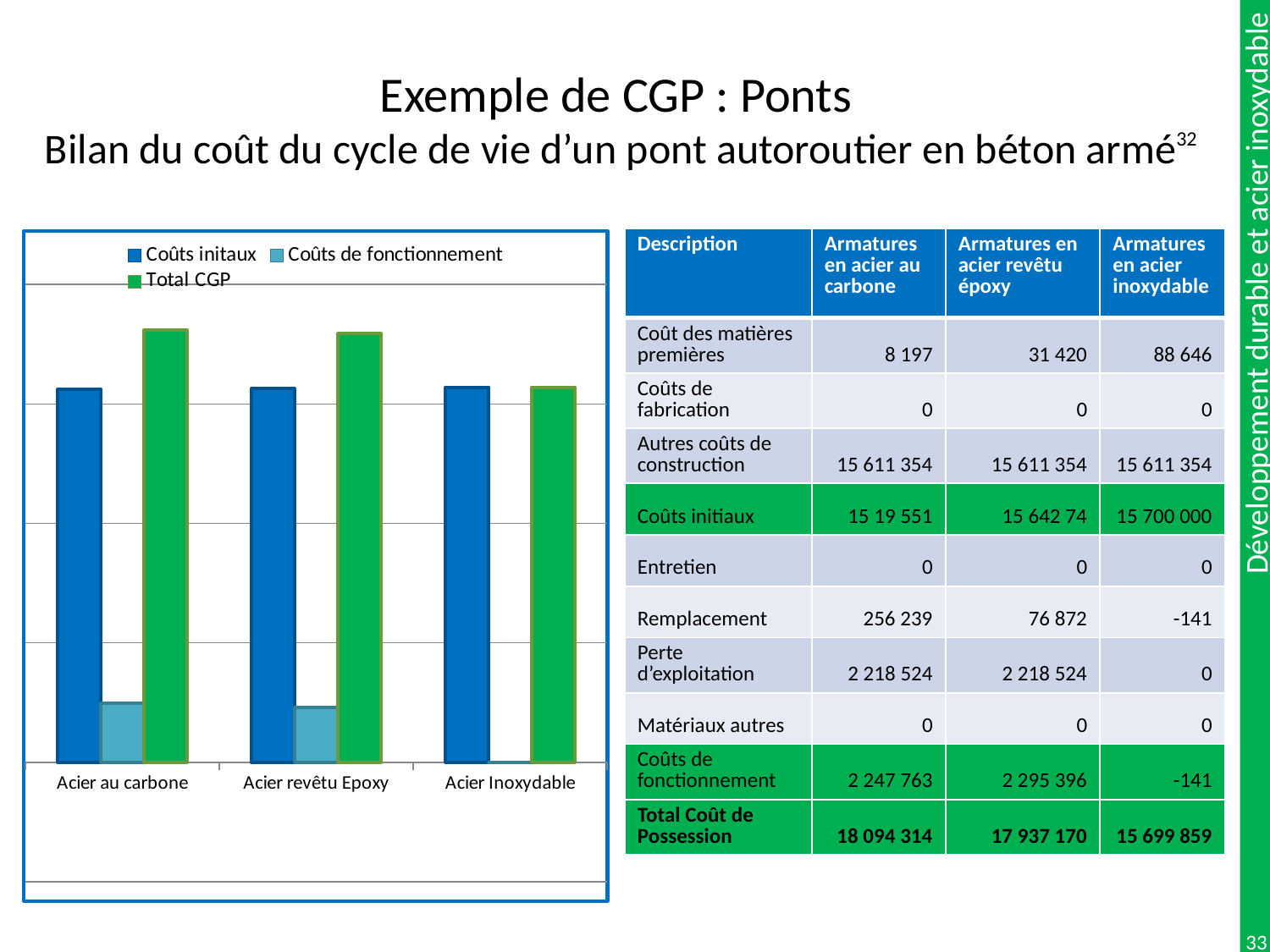
How many series does the chart legend list? 3 How many categories are shown on the x axis of the chart? 3 Which category has the lowest Coûts de fonctionnement bar in the chart? Acier Inoxydable Which category has the lowest Total CGP bar in the chart? Acier Inoxydable What is the name of the first series listed in the chart legend? Coûts initaux In the chart, is the Total CGP bar larger for Acier revêtu Epoxy or for Acier Inoxydable? Acier revêtu Epoxy Do the Total CGP bars rise or fall from left to right across the categories in the chart? fall In the chart, is the Coûts de fonctionnement bar larger for Acier revêtu Epoxy or for Acier Inoxydable? Acier revêtu Epoxy What kind of chart is shown on the left of the slide? bar chart In the chart, is the Total CGP bar larger for Acier au carbone or for Acier Inoxydable? Acier au carbone Which series in the chart is drawn in green? Total CGP